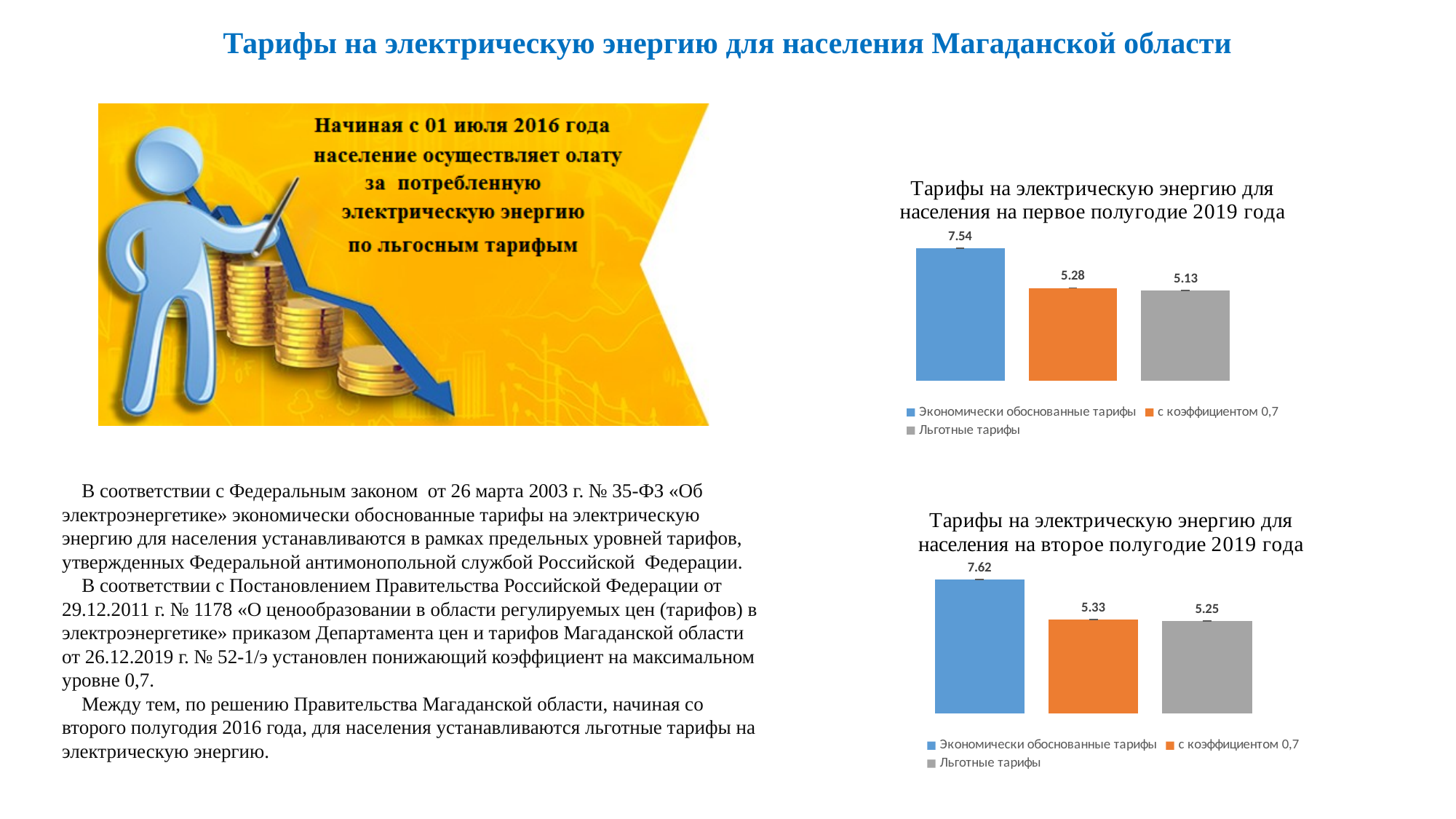
In the chart for the second half of 2019 (bottom chart), what is the difference between 'с коэффициентом 0,7' and 'Льготные тарифы'? 0.08 In the chart for the second half of 2019 (bottom chart), which series has the lowest value? Льготные тарифы In the chart 'Тарифы на электрическую энергию для населения на второе полугодие 2019 года', what is the value for 'с коэффициентом 0,7'? 5.33 In the chart 'Тарифы на электрическую энергию для населения на первое полугодие 2019 года', what is the value for 'Льготные тарифы'? 5.13 What kind of chart is the top chart on the slide? Bar chart How many series does the legend of the bottom chart list? 3 In the chart for the first half of 2019 (top chart), which is larger: 'с коэффициентом 0,7' or 'Льготные тарифы'? с коэффициентом 0,7 In the chart 'Тарифы на электрическую энергию для населения на второе полугодие 2019 года', what is the value for 'Экономически обоснованные тарифы'? 7.62 In the chart for the first half of 2019 (top chart), what is the difference between 'Экономически обоснованные тарифы' and 'Льготные тарифы'? 2.41 In the chart 'Тарифы на электрическую энергию для населения на первое полугодие 2019 года', what is the value for 'Экономически обоснованные тарифы'? 7.54 In the chart for the first half of 2019 (top chart), which series has the highest value? Экономически обоснованные тарифы In the bottom chart, what colour is the bar for 'Льготные тарифы'? Grey